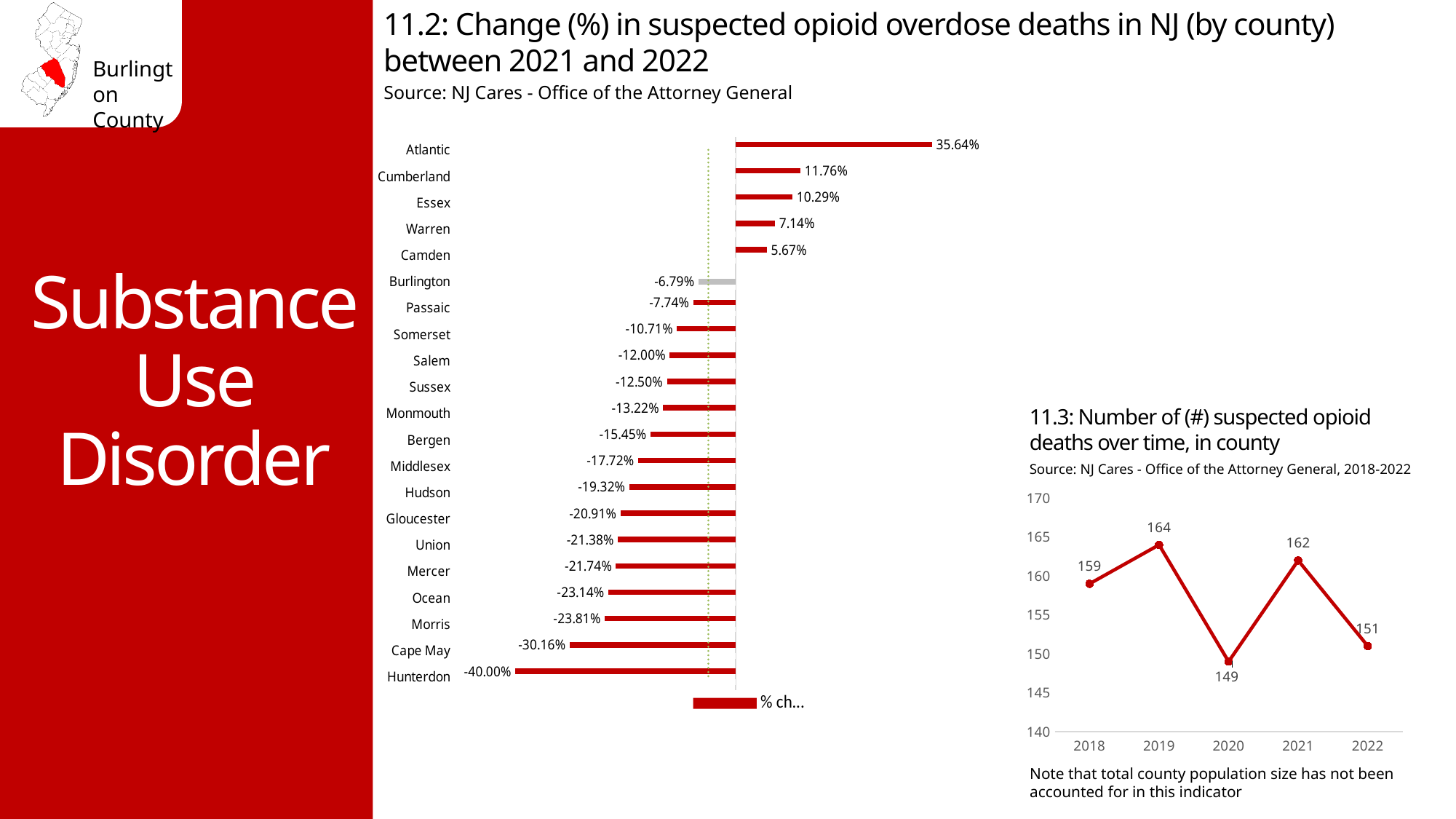
In the chart '11.2: Change (%) in suspected opioid overdose deaths in NJ (by county) between 2021 and 2022', what is the value for Atlantic? 35.64% In the chart '11.3: Number of (#) suspected opioid deaths over time, in county', which year has the highest value? 2019 In the chart '11.2: Change (%) in suspected opioid overdose deaths in NJ (by county) between 2021 and 2022', which is larger, the value for Essex or the value for Cumberland? Cumberland In the chart '11.3: Number of (#) suspected opioid deaths over time, in county', how many data points are plotted? 5 In the chart '11.3: Number of (#) suspected opioid deaths over time, in county', what is the value for 2020? 149 In the chart '11.2: Change (%) in suspected opioid overdose deaths in NJ (by county) between 2021 and 2022', which county has the highest value? Atlantic In the chart '11.2: Change (%) in suspected opioid overdose deaths in NJ (by county) between 2021 and 2022', what type of chart is used? Bar chart In the chart '11.2: Change (%) in suspected opioid overdose deaths in NJ (by county) between 2021 and 2022', which county has the lowest value? Hunterdon In the chart '11.3: Number of (#) suspected opioid deaths over time, in county', what type of chart is used? Line chart In the chart '11.3: Number of (#) suspected opioid deaths over time, in county', what is the difference between the 2019 value and the 2020 value? 15 In the chart '11.2: Change (%) in suspected opioid overdose deaths in NJ (by county) between 2021 and 2022', what is the value for Burlington? -6.79% In the chart '11.2: Change (%) in suspected opioid overdose deaths in NJ (by county) between 2021 and 2022', how many counties are shown? 21